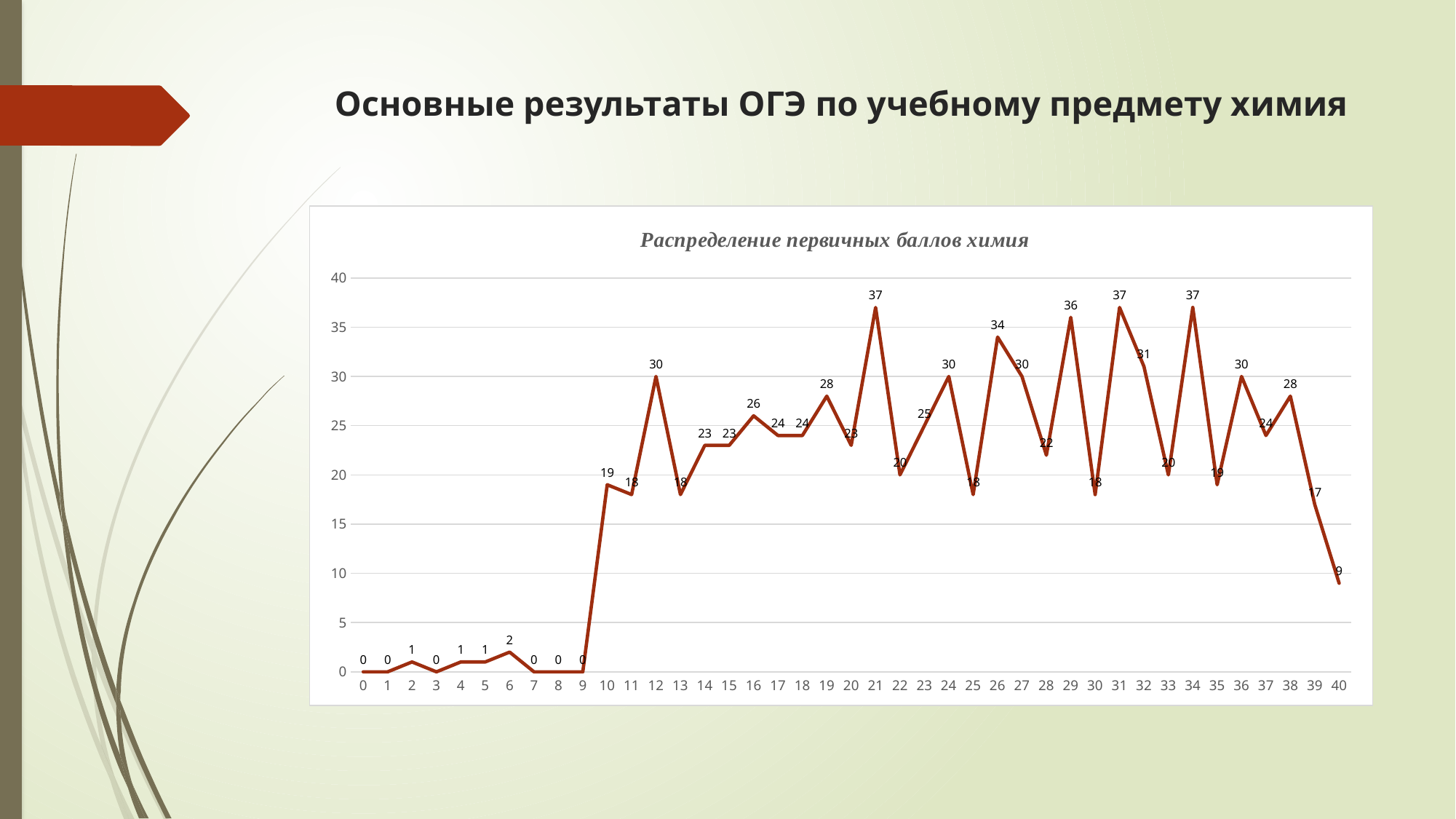
Which has the larger value, score 29 or score 26? 29 What is the value plotted for score 21 in the chart? 37 What is the difference between the values for score 21 and score 22? 17 What is the value plotted for score 6 in the chart? 2 What is the title of the chart? Распределение первичных баллов химия How many score points are plotted along the x axis of the chart? 41 What is the highest value reached by the line in the chart? 37 What is the difference between the values for score 26 and score 25? 16 What is the value plotted for score 12 in the chart? 30 What is the value plotted for score 40 in the chart? 9 Is the value for score 10 greater or less than 15? greater What kind of chart is shown on the slide? line chart